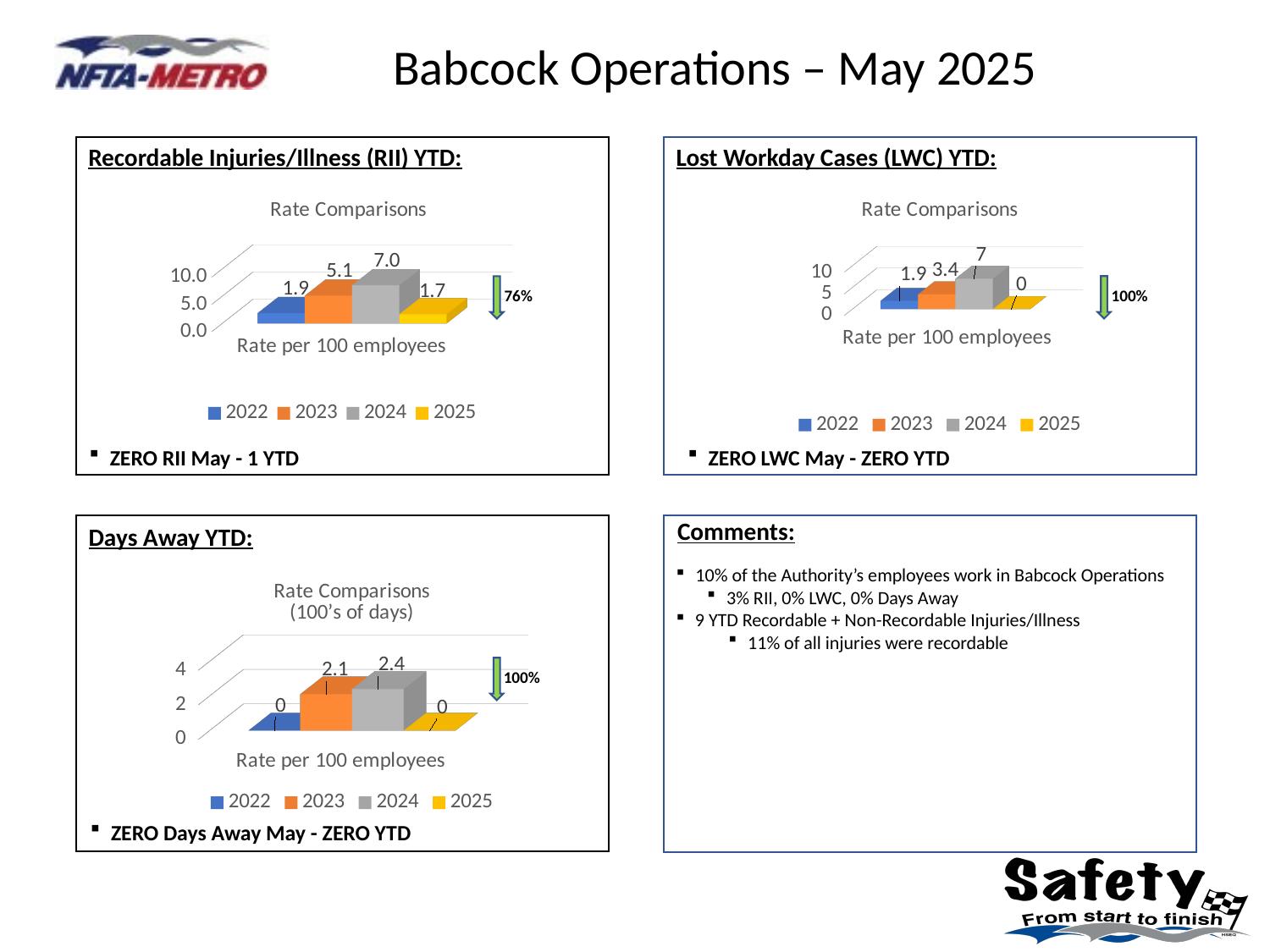
What kind of chart is shown in the Lost Workday Cases (LWC) YTD box? bar chart In the Recordable Injuries/Illness (RII) YTD chart, what is the value for 2024? 7.0 In the Lost Workday Cases (LWC) YTD chart, what is the value for 2023? 3.4 In the Lost Workday Cases (LWC) YTD chart, which year has the lowest rate? 2025 In the Recordable Injuries/Illness (RII) YTD chart, what is the difference between the 2024 and 2025 values? 5.3 How many series does the legend list in the Days Away YTD chart? 4 In the Recordable Injuries/Illness (RII) YTD chart, what is the value for 2025? 1.7 In the Lost Workday Cases (LWC) YTD chart, is the value for 2022 larger or smaller than the value for 2024? smaller In the Days Away YTD chart, what is the difference between the 2024 and 2023 values? 0.3 What is the x-axis category label in the Recordable Injuries/Illness (RII) YTD chart? Rate per 100 employees In the Recordable Injuries/Illness (RII) YTD chart, which year has the highest rate? 2024 In the Days Away YTD chart, what is the value for 2024? 2.4